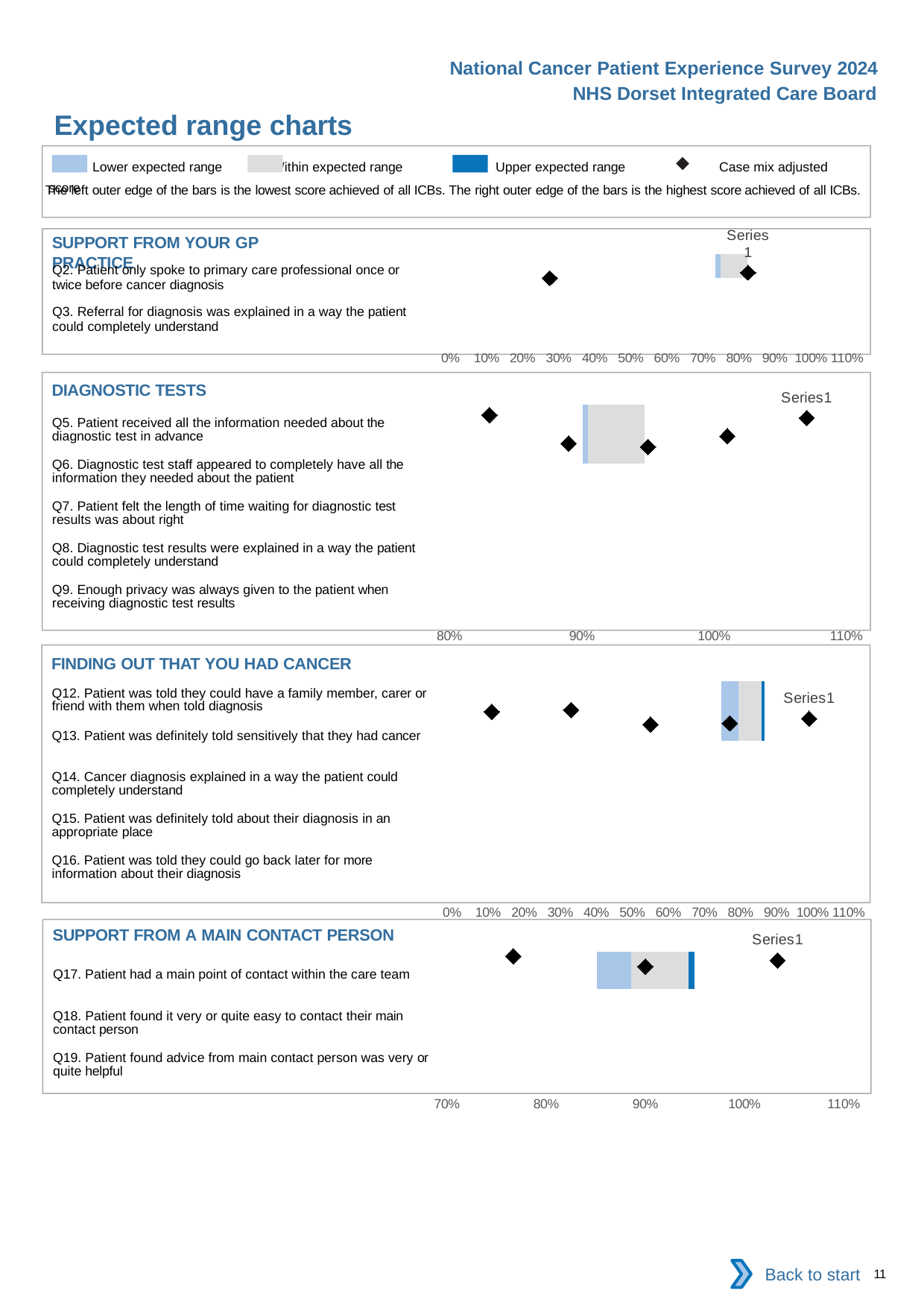
How many questions are listed in the SUPPORT FROM A MAIN CONTACT PERSON chart? 3 How many questions are listed in the SUPPORT FROM YOUR GP PRACTICE chart? 2 How many questions are listed in the DIAGNOSTIC TESTS chart? 5 In the SUPPORT FROM YOUR GP PRACTICE chart, is the leftmost diamond marker greater or less than 50%? less What kind of chart is the SUPPORT FROM A MAIN CONTACT PERSON chart? bar chart What is the lowest value shown on the x axis of the SUPPORT FROM A MAIN CONTACT PERSON chart? 70% How many series does the legend of the DIAGNOSTIC TESTS chart list? 1 According to the legend at the top of the slide, what does the diamond marker represent? Case mix adjusted score